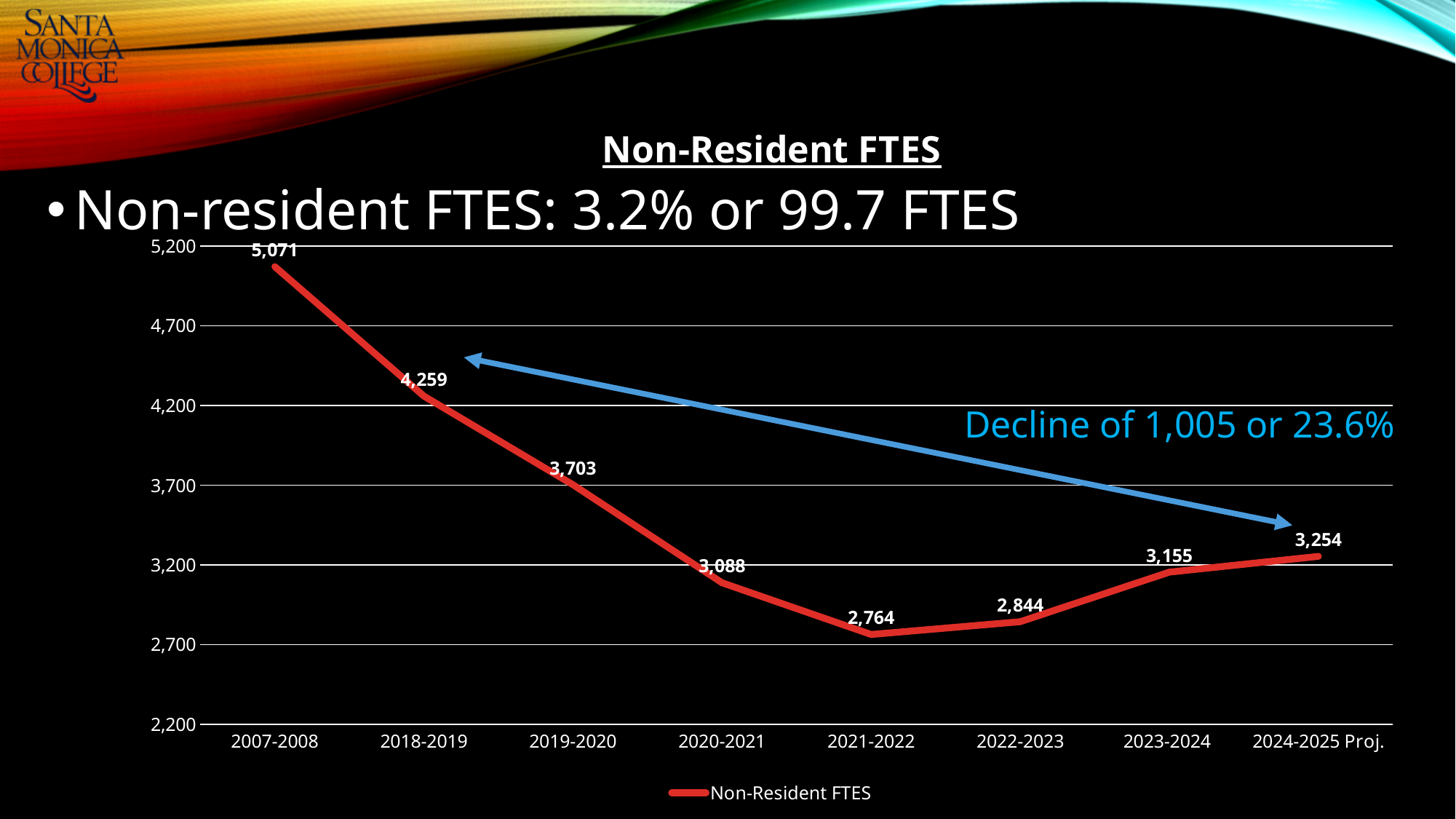
Which is larger, the Non-Resident FTES for 2020-2021 or for 2022-2023? 2020-2021 Is the Non-Resident FTES value for 2019-2020 greater or less than 3,700? greater How many academic years are plotted on the x axis? 8 Which year has the highest Non-Resident FTES? 2007-2008 Which year has the lowest Non-Resident FTES? 2021-2022 What is the Non-Resident FTES value for 2021-2022? 2,764 What is the difference in Non-Resident FTES between 2007-2008 and 2018-2019? 812 What is the Non-Resident FTES value for 2024-2025 Proj.? 3,254 What kind of chart is shown on the slide? line chart What is the difference in Non-Resident FTES between 2024-2025 Proj. and 2023-2024? 99 What is the title of the chart? Non-Resident FTES What is the Non-Resident FTES value for 2007-2008? 5,071